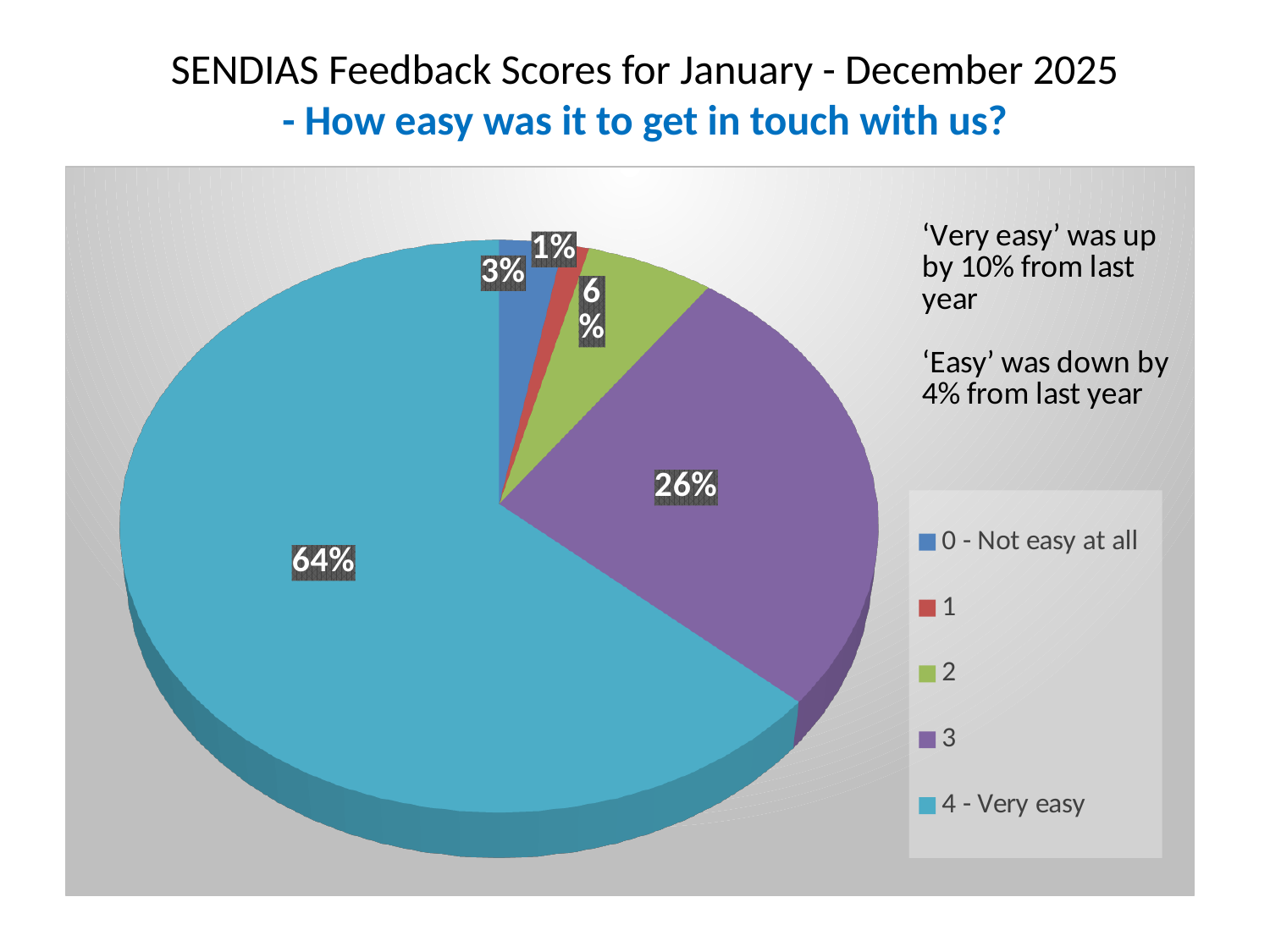
What is the difference in percentage points between '4 - Very easy' and '3'? 38 What percentage of respondents answered '4 - Very easy'? 64% What type of chart is shown on the slide? Pie chart What percentage of respondents answered '3'? 26% Which response category has the largest share of the pie? 4 - Very easy Which response category has the smallest share of the pie? 1 What percentage of respondents answered '0 - Not easy at all'? 3% What percentage of respondents answered '2'? 6% What percentage of respondents answered '1'? 1% How many response categories are shown in the pie chart? 5 What colour represents the '3' category in the pie chart? Purple Which is larger, the share for '2' or the share for '0 - Not easy at all'? 2